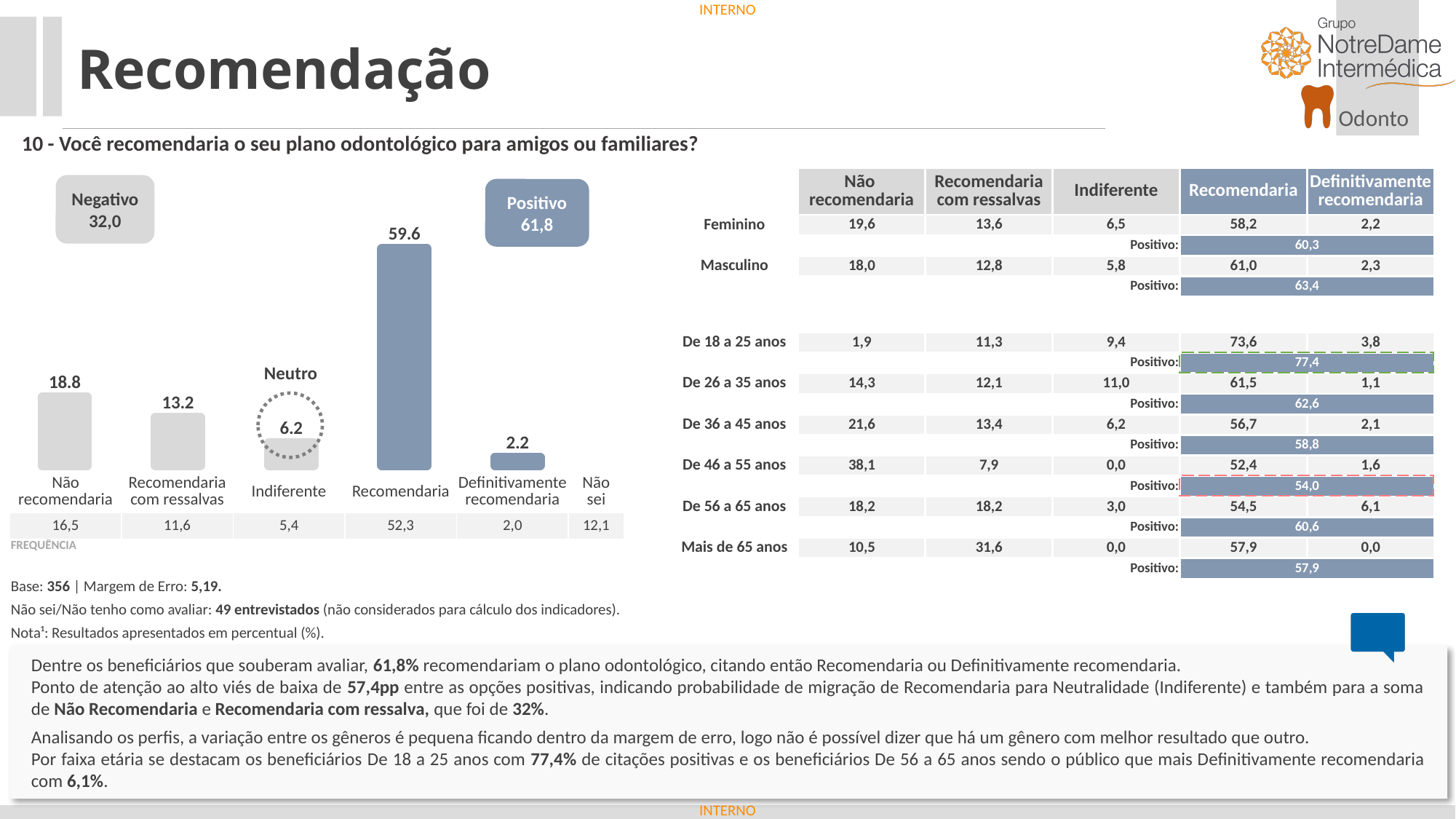
What is the difference between the Não recomendaria bar and the Recomendaria com ressalvas bar? 5.6 Which is larger in the chart, Recomendaria com ressalvas or Indiferente? Recomendaria com ressalvas What is the value of the Recomendaria bar in the chart? 59.6 How many bars are plotted in the chart? 5 What is the difference between the Recomendaria bar and the Não recomendaria bar? 40.8 What is the value of the Não recomendaria bar in the chart? 18.8 What is the value of the Definitivamente recomendaria bar in the chart? 2.2 What kind of chart is shown on the slide? Bar chart Which category has the highest bar in the chart? Recomendaria Which category has the lowest bar in the chart? Definitivamente recomendaria What value is shown in the 'Positivo' box above the chart? 61,8 What is the value of the Indiferente bar in the chart? 6.2